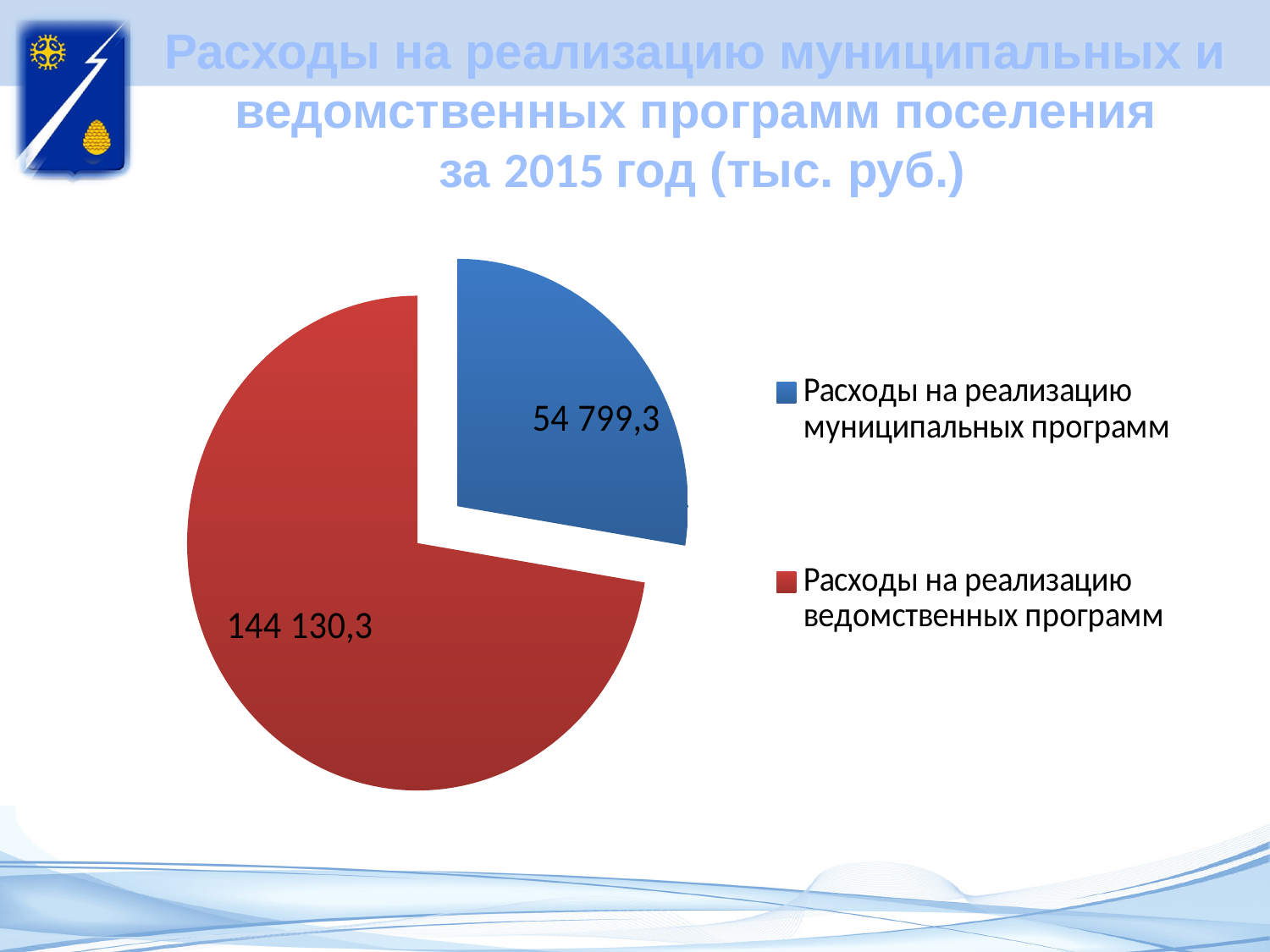
Which category has the smallest slice of the pie? Расходы на реализацию муниципальных программ What is the value for Расходы на реализацию ведомственных программ? 144 130,3 How many slices does the pie chart have? 2 What is the difference between the value for ведомственных программ and the value for муниципальных программ? 89 331,0 What colour is the slice for Расходы на реализацию ведомственных программ? Red What share of the pie does Расходы на реализацию муниципальных программ represent? 27.5% What is the value for Расходы на реализацию муниципальных программ? 54 799,3 What is the total of the two slices in the pie chart? 198 929,6 Which is larger: the value for муниципальных программ or the value for ведомственных программ? Ведомственных программ How many entries does the legend list? 2 What kind of chart is shown on the slide? Pie chart Which category has the largest slice of the pie? Расходы на реализацию ведомственных программ